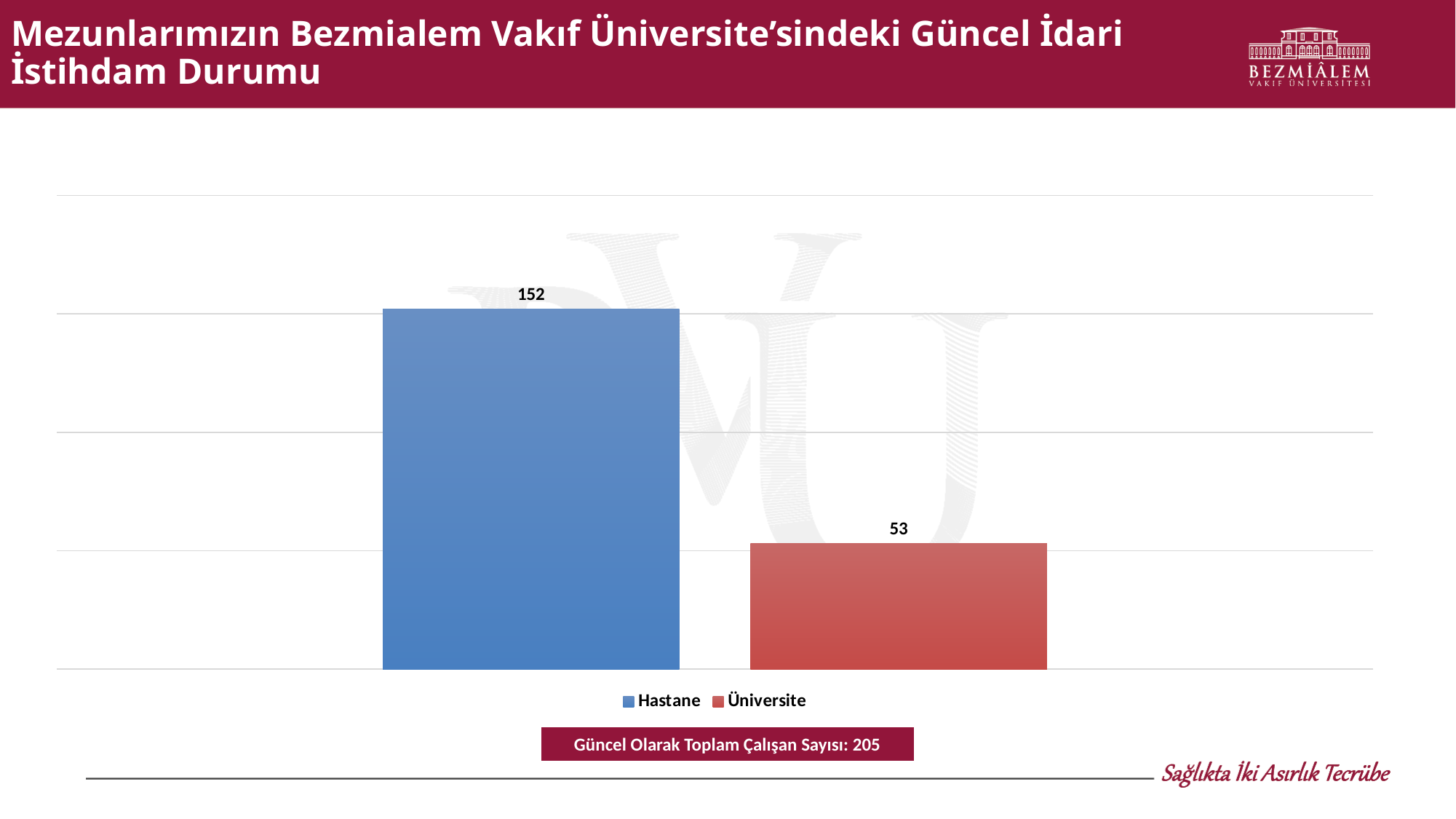
What total number of current employees is stated in the box below the chart? 205 What kind of chart is shown on the slide? Bar chart How many bars are plotted in the chart? 2 What is the total of the Hastane and Üniversite values? 205 What is the value for Üniversite? 53 What is the difference between the Hastane and Üniversite values? 99 What colour is the Hastane bar? Blue How many series does the legend list? 2 Which series has the lowest value? Üniversite What is the value for Hastane? 152 Which series has the highest value? Hastane Which is larger, the value for Hastane or the value for Üniversite? Hastane